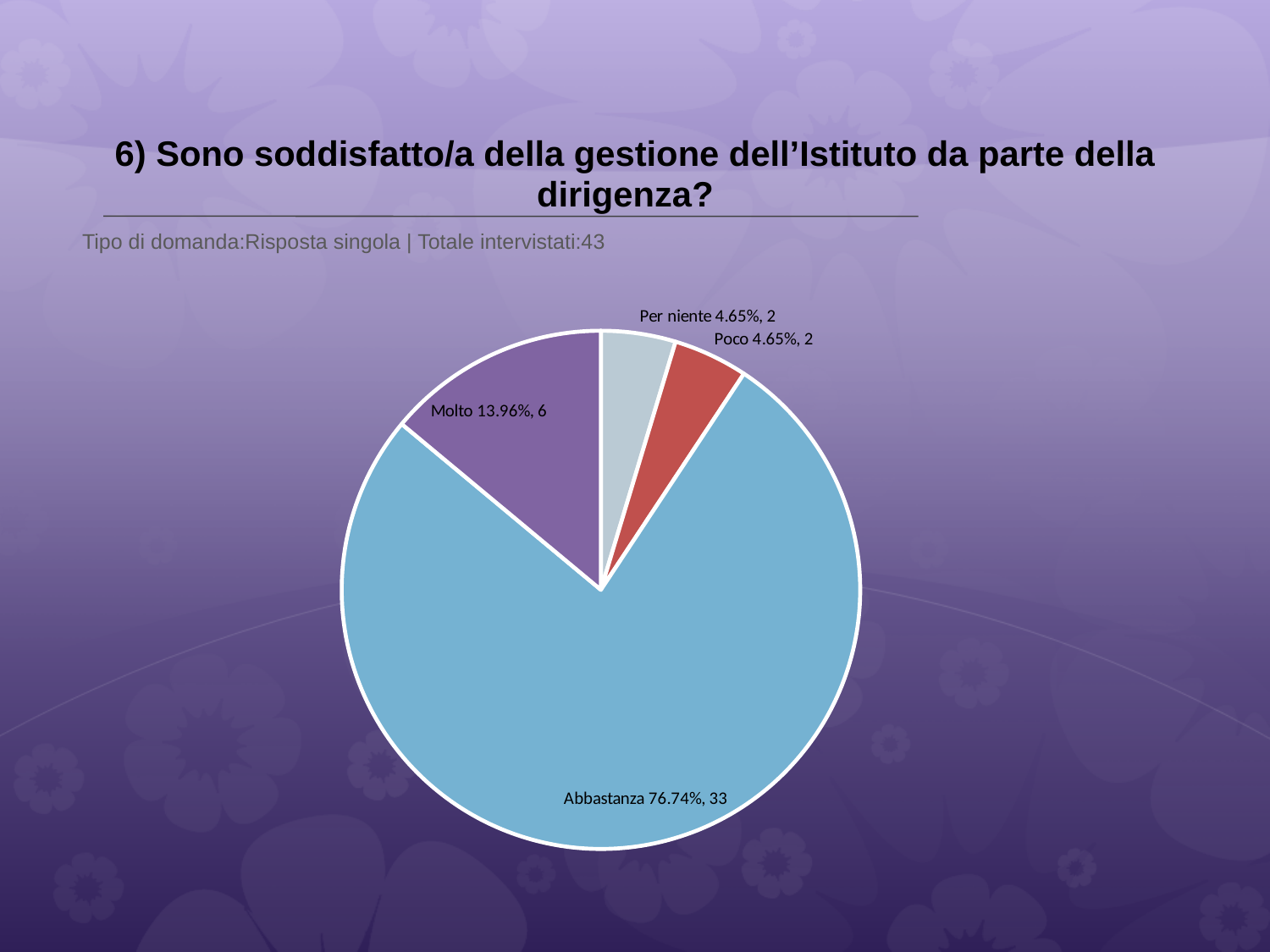
What colour is the Abbastanza slice? light blue Which category has the largest slice? Abbastanza What percentage share does the Per niente slice have? 4.65% What percentage share does the Abbastanza slice have? 76.74% Which is larger, the Molto slice or the Poco slice? Molto How many respondents answered Poco? 2 What percentage share does the Molto slice have? 13.96% How many respondents answered Molto? 6 How many slices does the pie chart have? 4 What kind of chart is shown on the slide? pie chart What is the total number of respondents stated on the slide? 43 What is the difference in respondent count between Abbastanza and Molto? 27